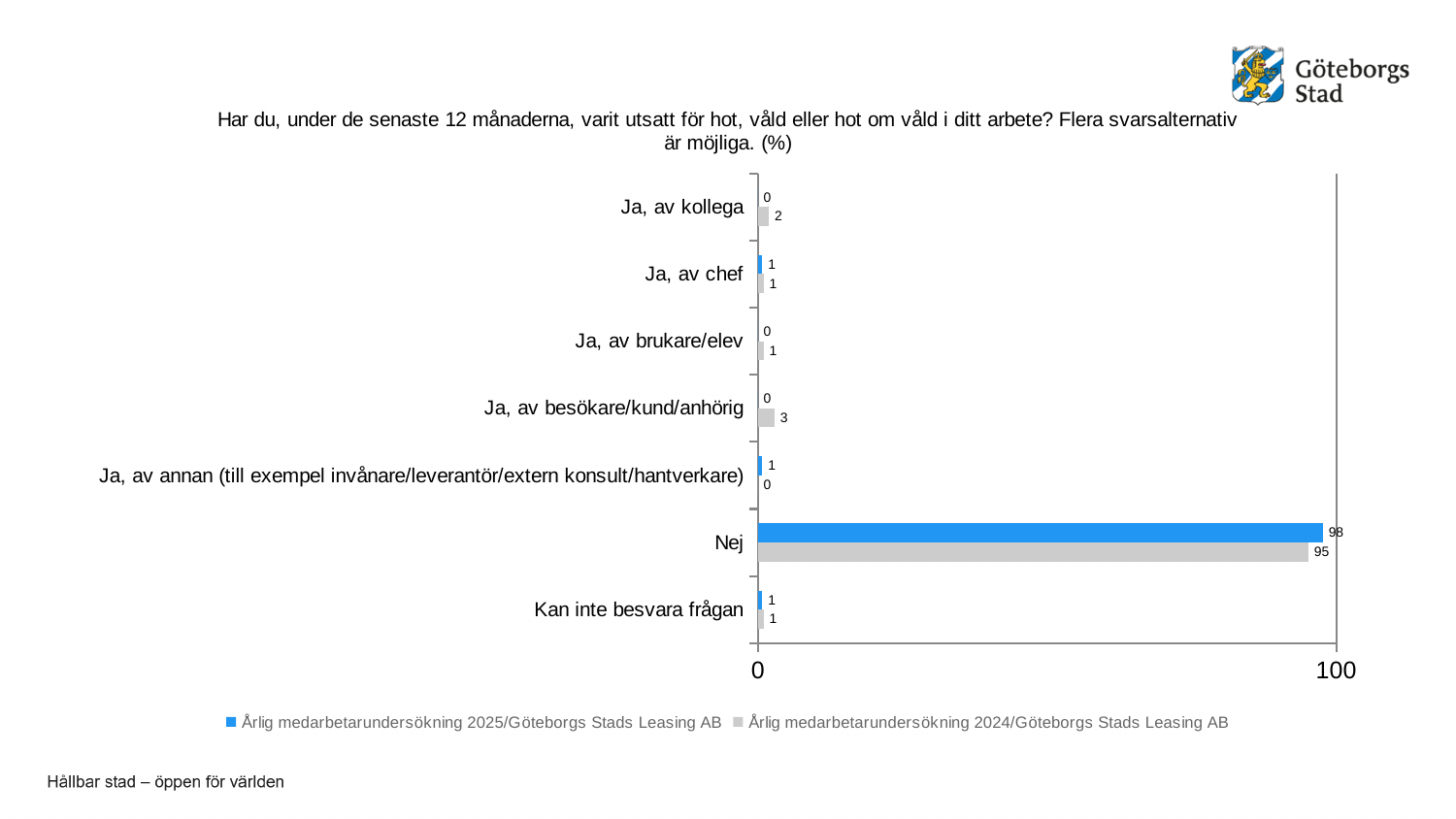
Which is larger for "Ja, av besökare/kund/anhörig": the 2025 value or the 2024 value? 2024 What kind of chart is shown on the slide? Bar chart What is the value for "Ja, av besökare/kund/anhörig" in the 2024 series? 3 What is the difference between the 2025 and 2024 values for "Nej"? 3 How many categories are shown on the chart? 7 What is the value for "Nej" in the 2024 series (Årlig medarbetarundersökning 2024/Göteborgs Stads Leasing AB)? 95 What is the value for "Ja, av annan (till exempel invånare/leverantör/extern konsult/hantverkare)" in the 2025 series? 1 How many series does the legend list? 2 Which category has the highest value in the 2025 series? Nej What is the value for "Nej" in the 2025 series (Årlig medarbetarundersökning 2025/Göteborgs Stads Leasing AB)? 98 What is the value for "Ja, av kollega" in the 2024 series? 2 Which colour represents the 2025 series (Årlig medarbetarundersökning 2025/Göteborgs Stads Leasing AB)? Blue